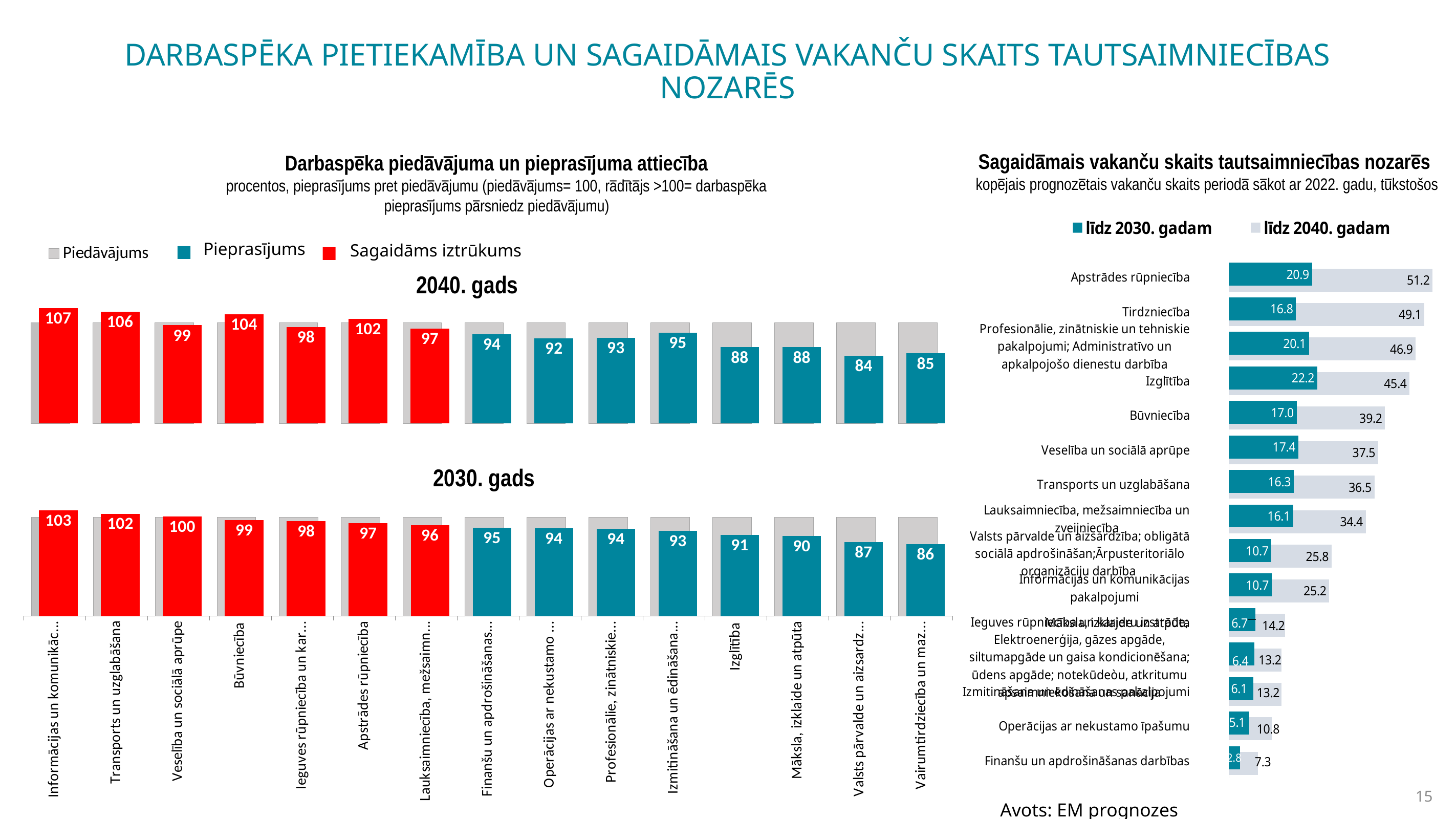
In the 2040. gads chart, what is the difference between the values for Būvniecība and Izglītība? 16 In the 2030. gads chart, what is the value for Veselība un sociālā aprūpe? 100 In the 2040. gads chart, which category has the highest value? Informācijas un komunikāc... In the 2040. gads chart, what is the value for Izglītība? 88 In the Sagaidāmais vakanču skaits tautsaimniecības nozarēs chart, what is the value for Izglītība līdz 2030. gadam? 22.2 In the Sagaidāmais vakanču skaits tautsaimniecības nozarēs chart, which category has the highest value līdz 2030. gadam? Izglītība In the 2030. gads chart, which category has the lowest value? Vairumtirdziecība un maz... How many series does the legend of the Sagaidāmais vakanču skaits tautsaimniecības nozarēs chart list? 2 In the 2030. gads chart, which is larger: the value for Būvniecība or the value for Izglītība? Būvniecība In the 2040. gads chart, what is the value for Būvniecība? 104 In the Sagaidāmais vakanču skaits tautsaimniecības nozarēs chart, what is the value for Apstrādes rūpniecība līdz 2040. gadam? 51.2 In the 2030. gads chart, what is the value for Transports un uzglabāšana? 102